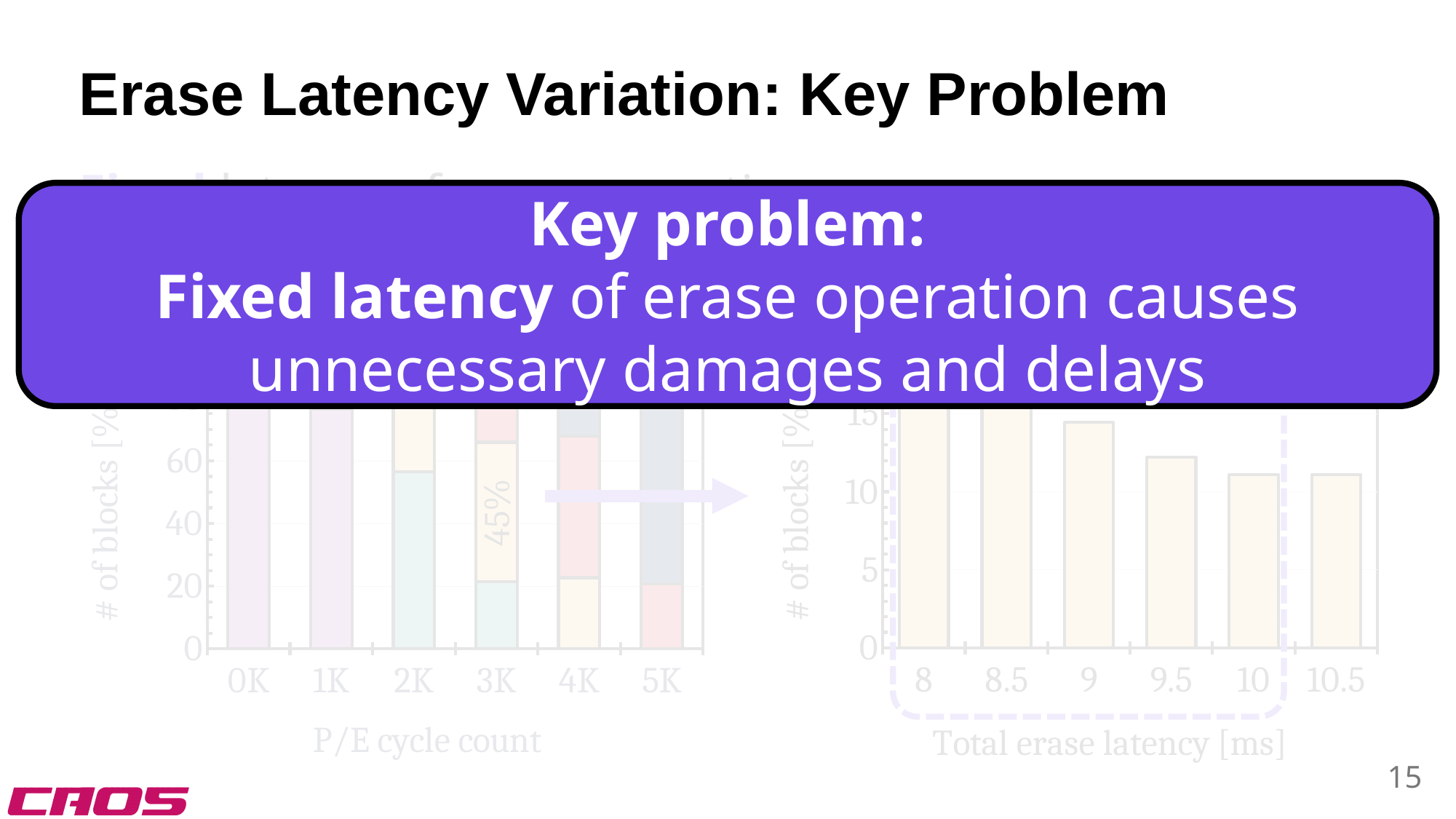
What is the x-axis title of the right chart? Total erase latency [ms] In the left chart (P/E cycle count), what percentage label is printed on the 3K bar? 45% How many bars are shown in the right chart (Total erase latency [ms])? 6 What kind of chart is the left chart with x axis 'P/E cycle count'? stacked bar chart In the right chart (Total erase latency [ms]), which is larger, the value for 9 or the value for 10? 9 What kind of chart is the right chart with x axis 'Total erase latency [ms]'? bar chart In the right chart (Total erase latency [ms]), is the value for 10.5 greater or less than 15? less In the right chart (Total erase latency [ms]), is the value for 9.5 greater or less than 10? greater In the right chart (Total erase latency [ms]), is the value for 9.5 greater or less than 15? less How many categories are shown on the x axis of the left chart (P/E cycle count)? 6 What is the x-axis title of the left chart? P/E cycle count In the right chart (Total erase latency [ms]), do the bar values generally rise or fall as total erase latency increases from 8 to 10.5? fall